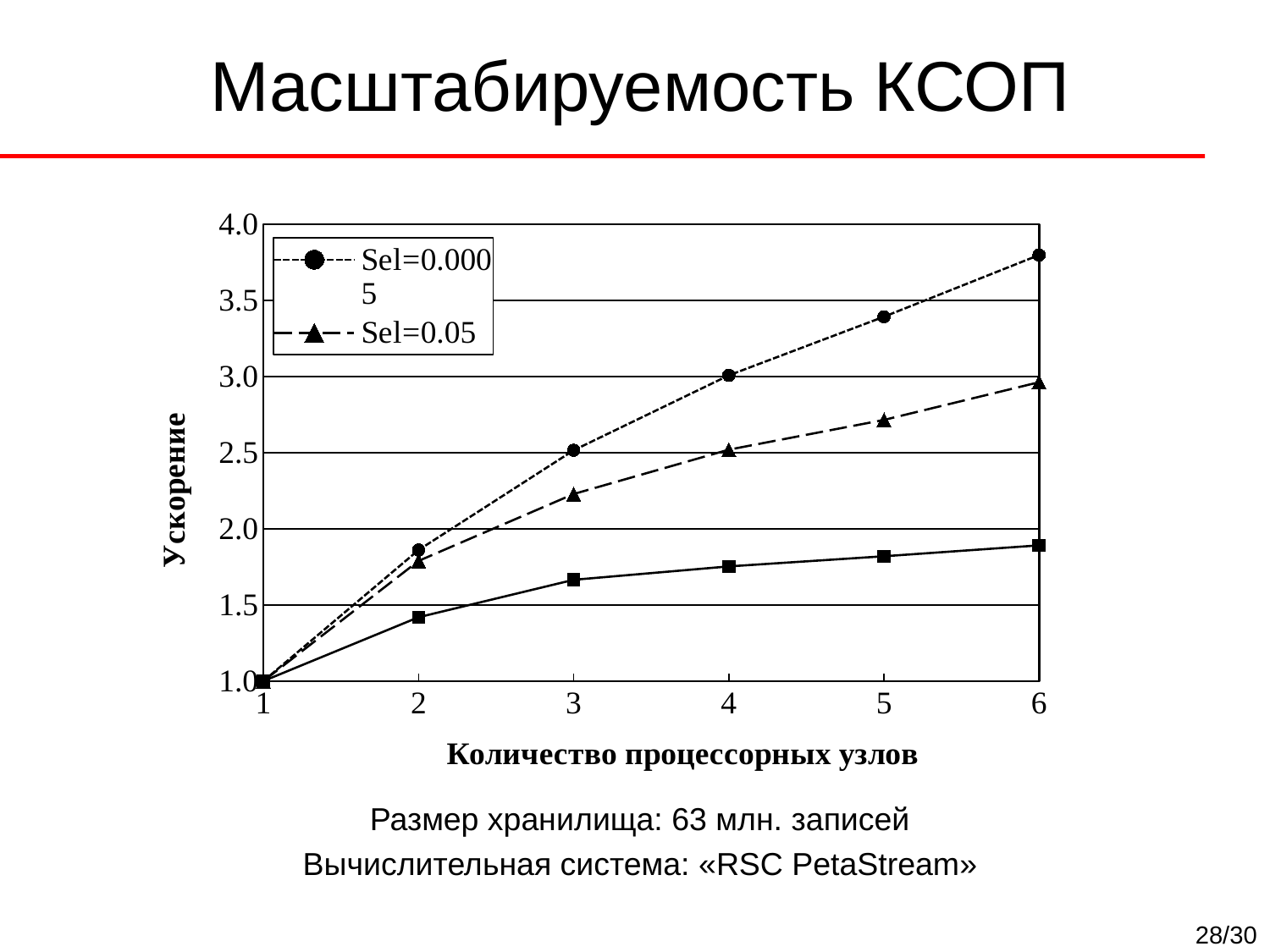
How many processor-node values are plotted along the x axis? 6 Is the value for Sel=0.05 at 3 processor nodes greater or less than 2.5? less What is the x-axis title of the chart? Количество процессорных узлов Which series has the higher value at 5 processor nodes, Sel=0.0005 or Sel=0.05? Sel=0.0005 How many series does the legend list? 2 Does the Sel=0.0005 series rise or fall as the number of processor nodes increases? rise Is the value for Sel=0.0005 at 4 processor nodes greater or less than 2.5? greater What kind of chart is shown on the slide? line chart Is the value for Sel=0.0005 at 6 processor nodes greater or less than 3.5? greater What is the y-axis title of the chart? Ускорение At which number of processor nodes does the Sel=0.05 series reach its highest value? 6